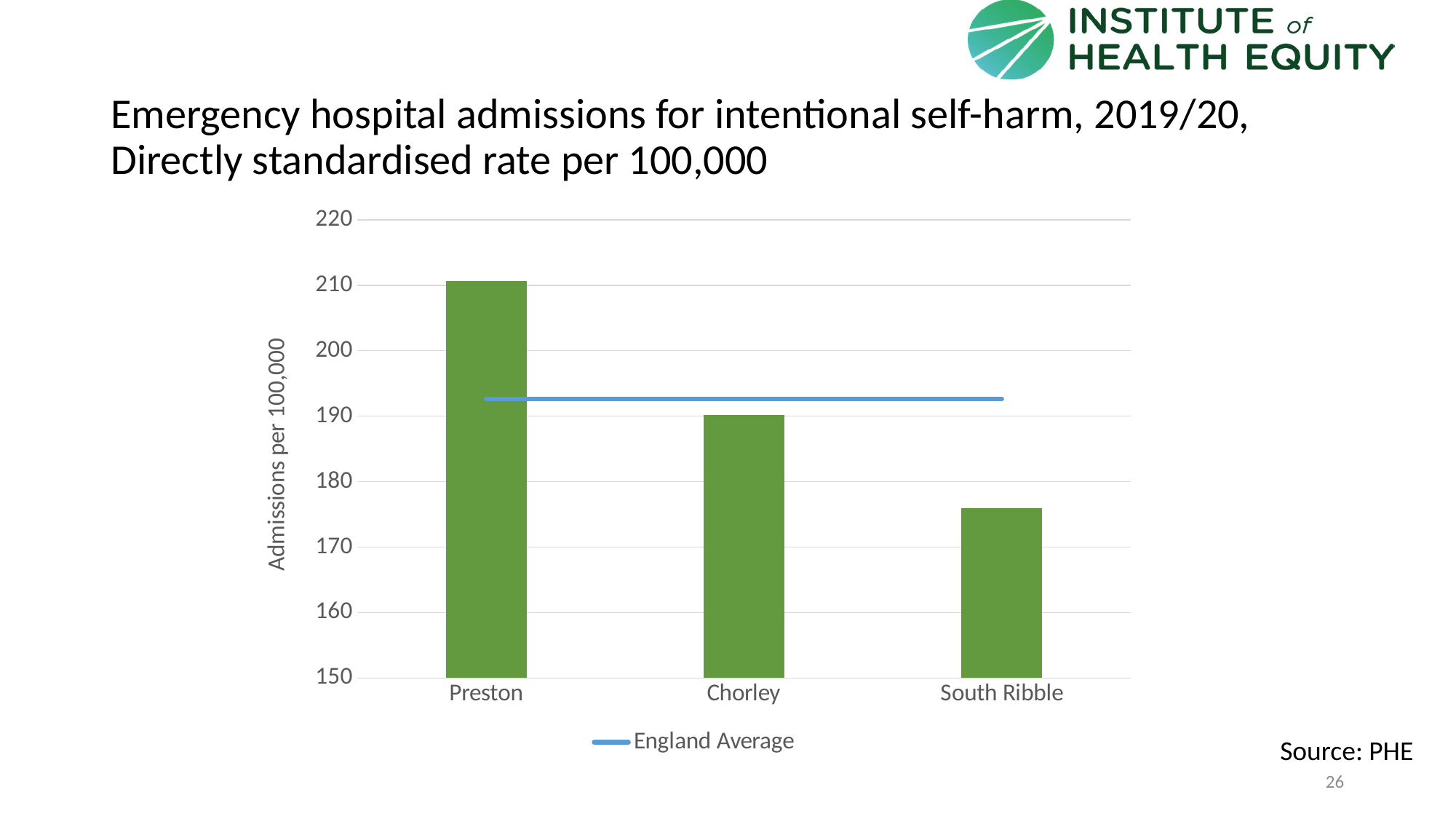
Which area has the lowest rate of emergency hospital admissions for intentional self-harm? South Ribble What is the label of the y axis of the chart? Admissions per 100,000 Which has the higher admission rate, Preston or Chorley? Preston Which area has the highest rate of emergency hospital admissions for intentional self-harm? Preston Is the value for Chorley greater or less than 200? less Is the value for South Ribble greater or less than 180? less What kind of chart is shown on the slide? bar chart How many entries does the chart's legend list? 1 Is the England Average line greater or less than 190? greater How many local areas are shown on the x axis of the chart? 3 Do the bar values rise or fall from Preston to South Ribble along the x axis? fall